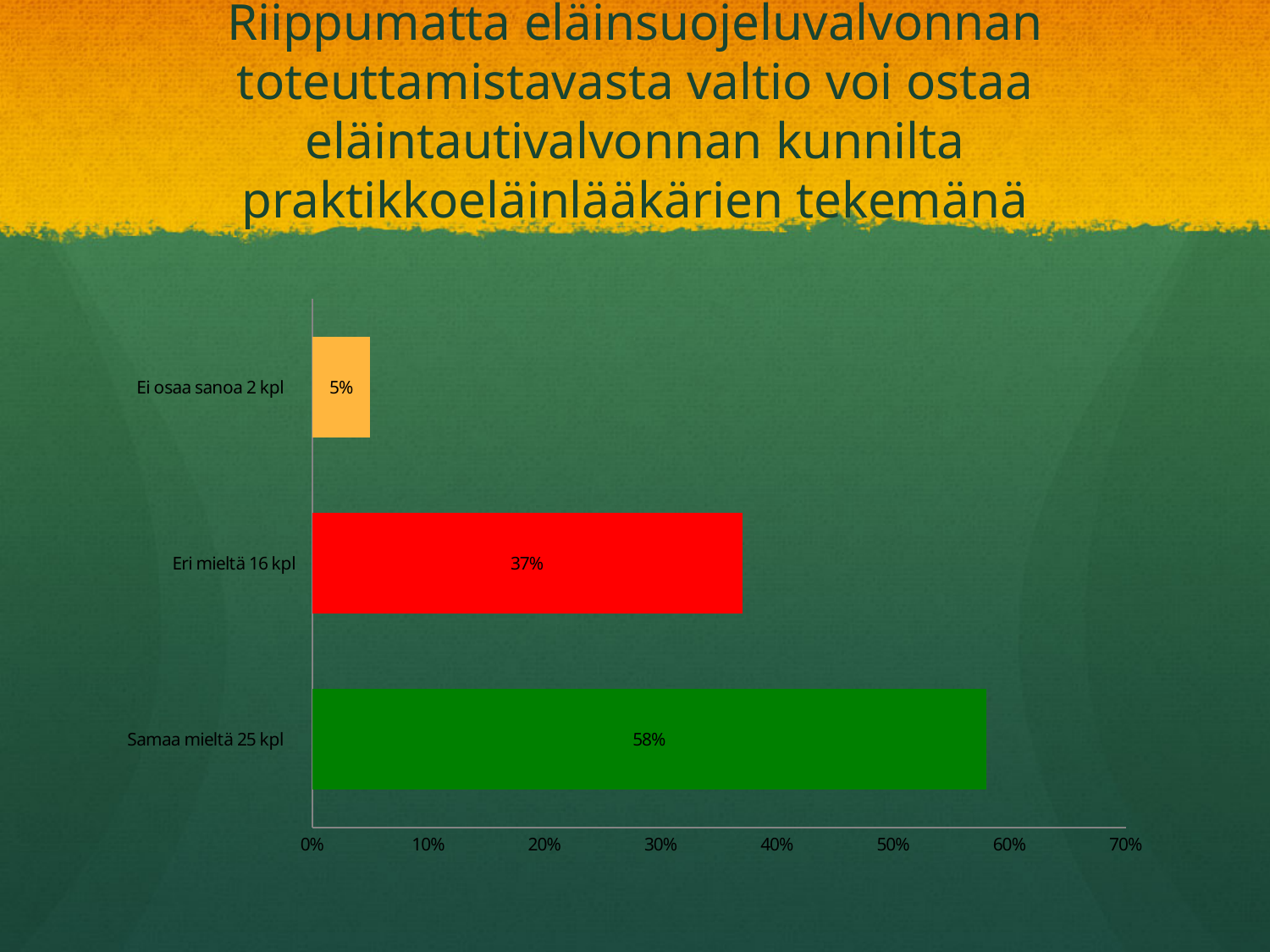
Which category has the highest value? Samaa mieltä 25 kpl Which category has the lowest value? Ei osaa sanoa 2 kpl What is the value for "Samaa mieltä 25 kpl"? 58% What kind of chart is shown on the slide? bar chart What is the value for "Ei osaa sanoa 2 kpl"? 5% Which is larger, the value for "Eri mieltä 16 kpl" or the value for "Ei osaa sanoa 2 kpl"? Eri mieltä 16 kpl What is the difference between the values for "Eri mieltä 16 kpl" and "Ei osaa sanoa 2 kpl"? 32% Is the value for "Samaa mieltä 25 kpl" greater or less than 50%? greater What colour is the bar for "Eri mieltä 16 kpl"? red What is the difference between the values for "Samaa mieltä 25 kpl" and "Eri mieltä 16 kpl"? 21% How many categories are shown in the chart? 3 What is the value for "Eri mieltä 16 kpl"? 37%